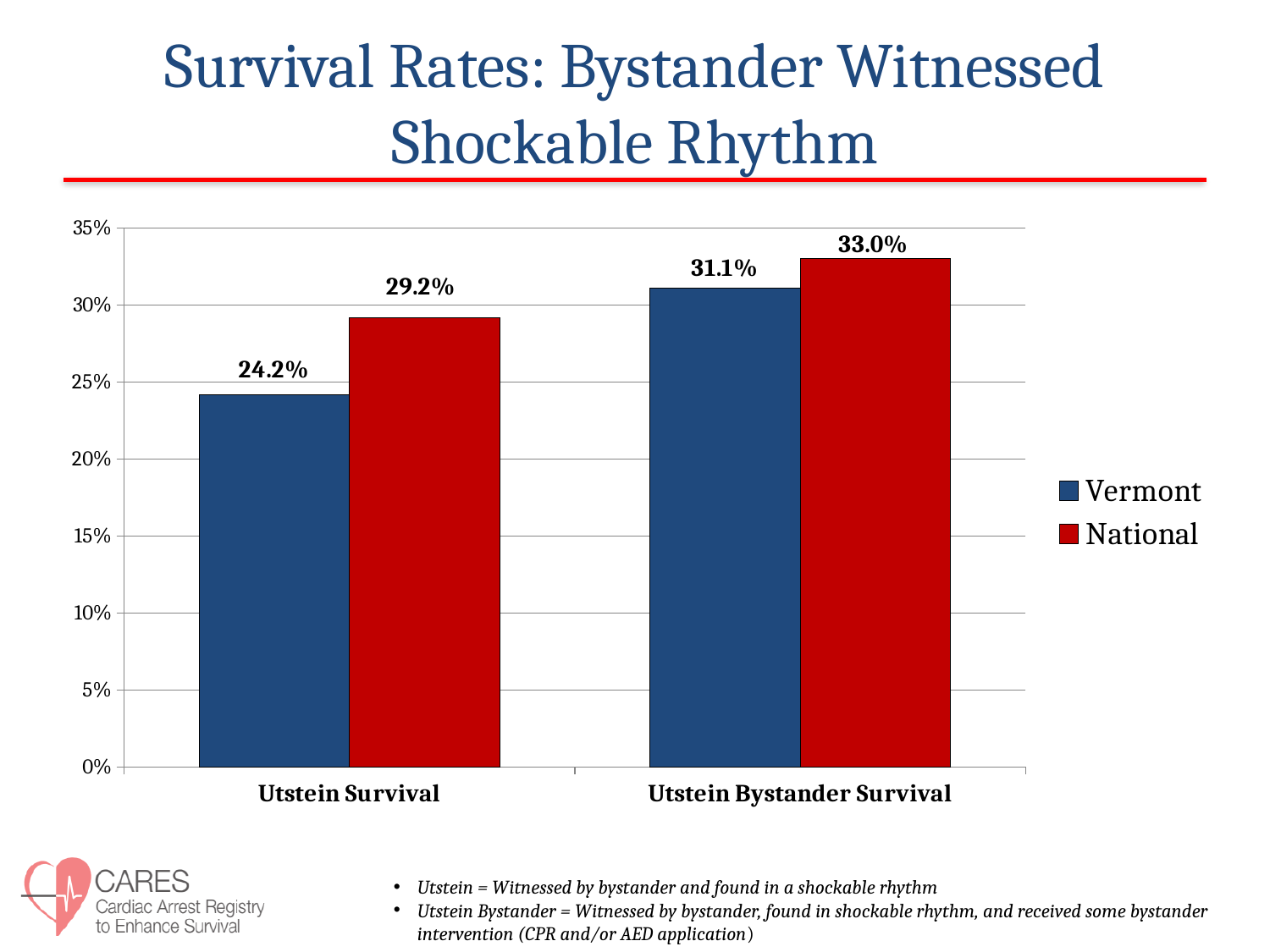
How many categories are shown on the x axis? 2 What is the difference between the National and Vermont values for Utstein Survival? 5.0% Which is larger for Utstein Bystander Survival, Vermont or National? National Which bar has the highest value on the chart? National, Utstein Bystander Survival What kind of chart is shown on the slide? Bar chart What is the difference between the National and Vermont values for Utstein Bystander Survival? 1.9% What is the Vermont value for Utstein Survival? 24.2% What is the National value for Utstein Survival? 29.2% Which bar has the lowest value on the chart? Vermont, Utstein Survival How many series does the legend list? 2 What is the National value for Utstein Bystander Survival? 33.0% What is the Vermont value for Utstein Bystander Survival? 31.1%